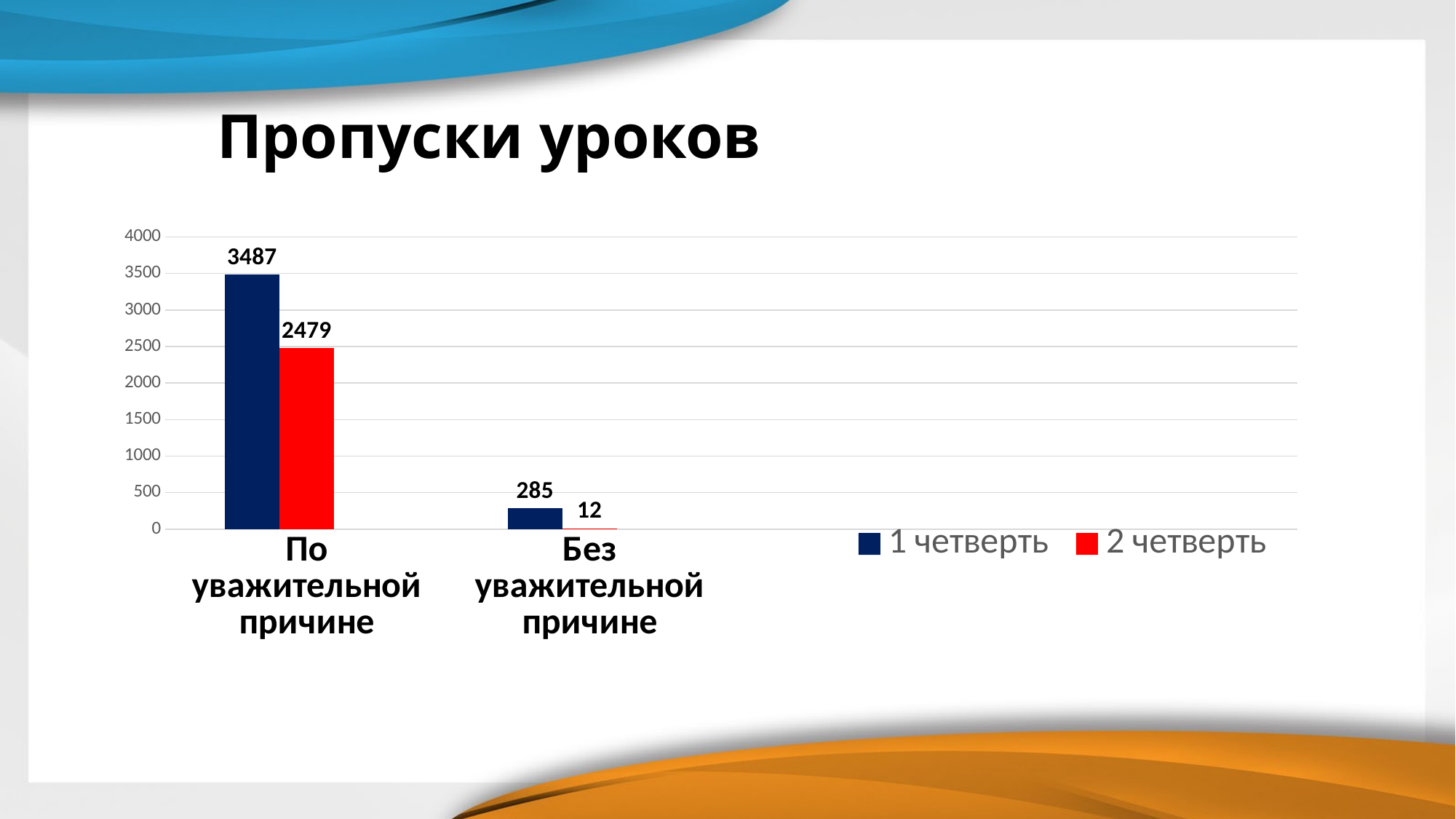
What is the difference between the '1 четверть' and '2 четверть' values for 'По уважительной причине'? 1008 Which bar has the lowest value on the chart? 2 четверть, Без уважительной причине What is the difference between the '1 четверть' and '2 четверть' values for 'Без уважительной причине'? 273 What is the value for '1 четверть' in the 'По уважительной причине' category? 3487 What is the value for '2 четверть' in the 'Без уважительной причине' category? 12 What type of chart is shown on the slide? Bar chart What is the value for '2 четверть' in the 'По уважительной причине' category? 2479 What is the value for '1 четверть' in the 'Без уважительной причине' category? 285 Which bar has the highest value on the chart? 1 четверть, По уважительной причине How many series does the legend list? 2 Which is larger: the '1 четверть' value for 'По уважительной причине' or the '1 четверть' value for 'Без уважительной причине'? По уважительной причине How many categories are shown on the x axis? 2